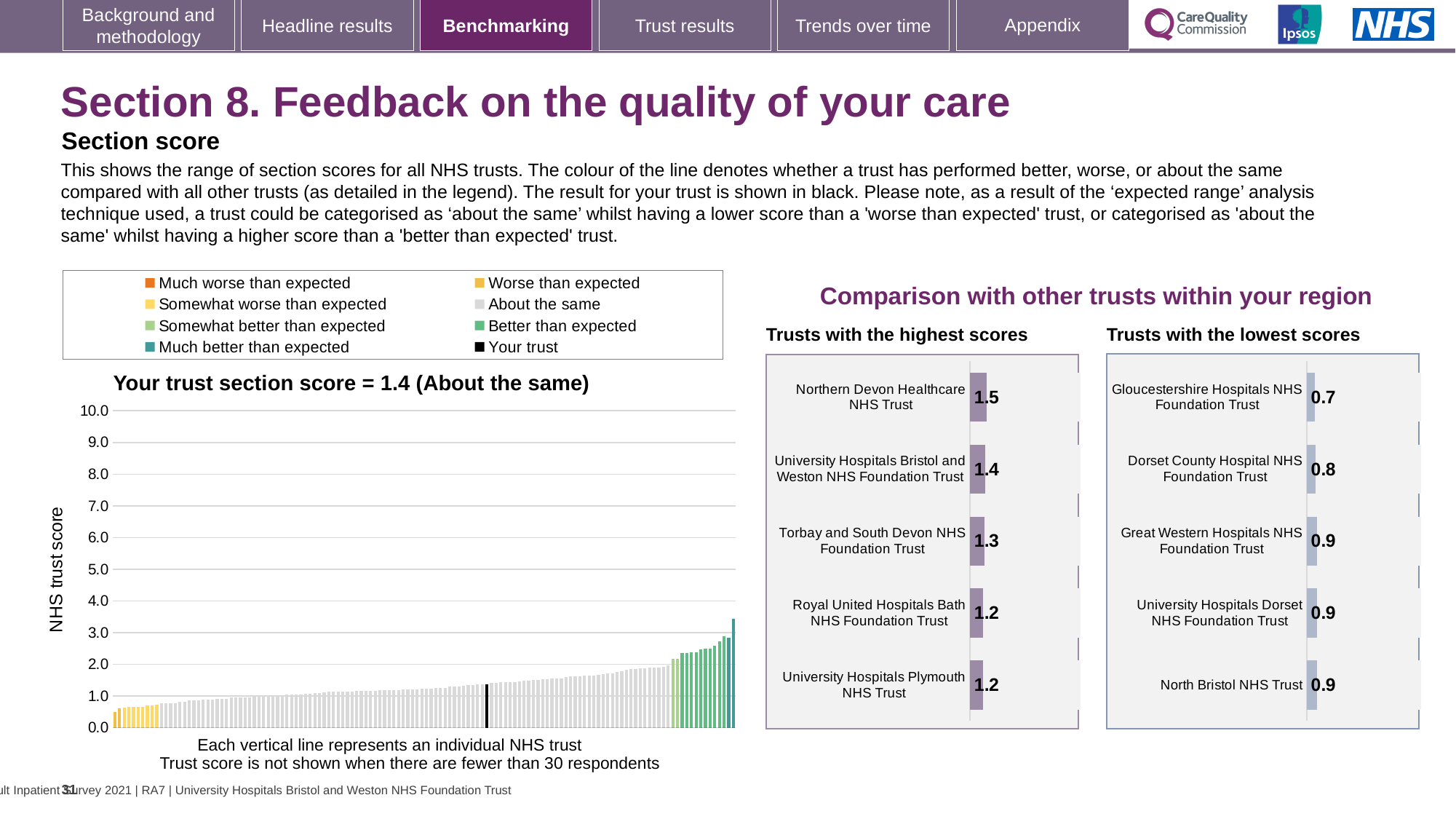
What kind of chart is the 'Your trust section score' chart? bar chart How many entries does the legend above the 'Your trust section score' chart list? 8 In the 'Trusts with the highest scores' chart, what is the difference between the scores of Northern Devon Healthcare NHS Trust and University Hospitals Plymouth NHS Trust? 0.3 In the 'Trusts with the lowest scores' chart, which has the larger score: Dorset County Hospital NHS Foundation Trust or North Bristol NHS Trust? North Bristol NHS Trust In the 'Your trust section score' chart, is the value of the tallest bar greater or less than 3.0? greater In the 'Trusts with the highest scores' chart, what is the score for Torbay and South Devon NHS Foundation Trust? 1.3 How many trusts are shown in the 'Trusts with the lowest scores' chart? 5 In the 'Trusts with the lowest scores' chart, which trust has the lowest score? Gloucestershire Hospitals NHS Foundation Trust In the 'Trusts with the highest scores' chart, which trust has the highest score? Northern Devon Healthcare NHS Trust In the 'Your trust section score' chart, do the trust scores rise or fall from left to right along the x axis? rise In the 'Your trust section score' chart, is the value of the black bar for your trust greater or less than 2.0? less In the 'Your trust section score' chart, what is the section score for your trust? 1.4